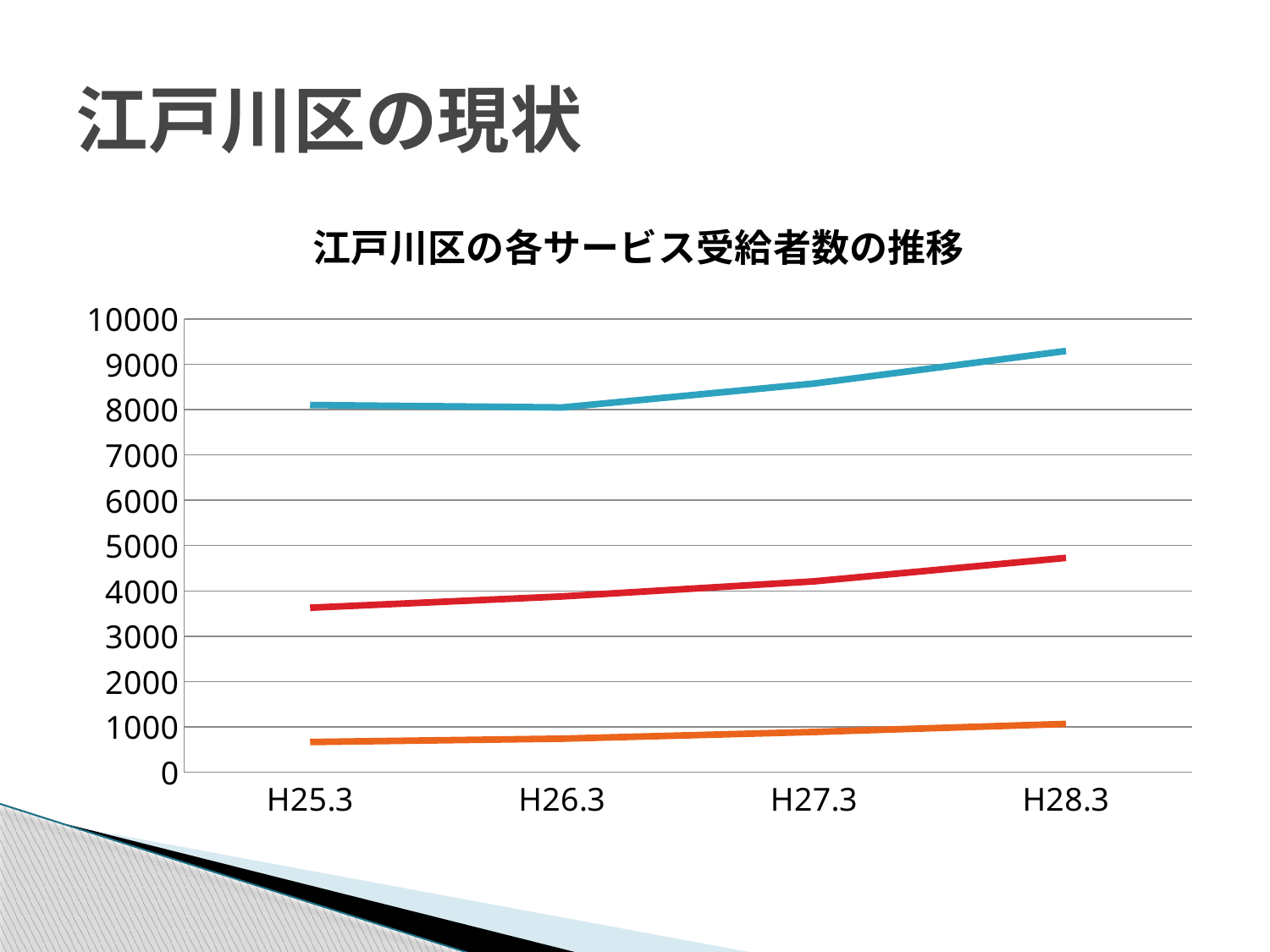
Which line has the lowest values across all time points? the orange line Is the value of the red line at H25.3 greater or less than 4000? less What is the title of the chart? 江戸川区の各サービス受給者数の推移 Is the value of the red line at H28.3 greater or less than 4000? greater What kind of chart is shown on the slide? line chart At H28.3, which line has the higher value, the blue line or the red line? the blue line How many time points are shown on the x axis of the chart? 4 Does the red line rise or fall from H25.3 to H28.3? rise How many lines are plotted on the chart? 3 Is the value of the blue line at H26.3 greater or less than 9000? less